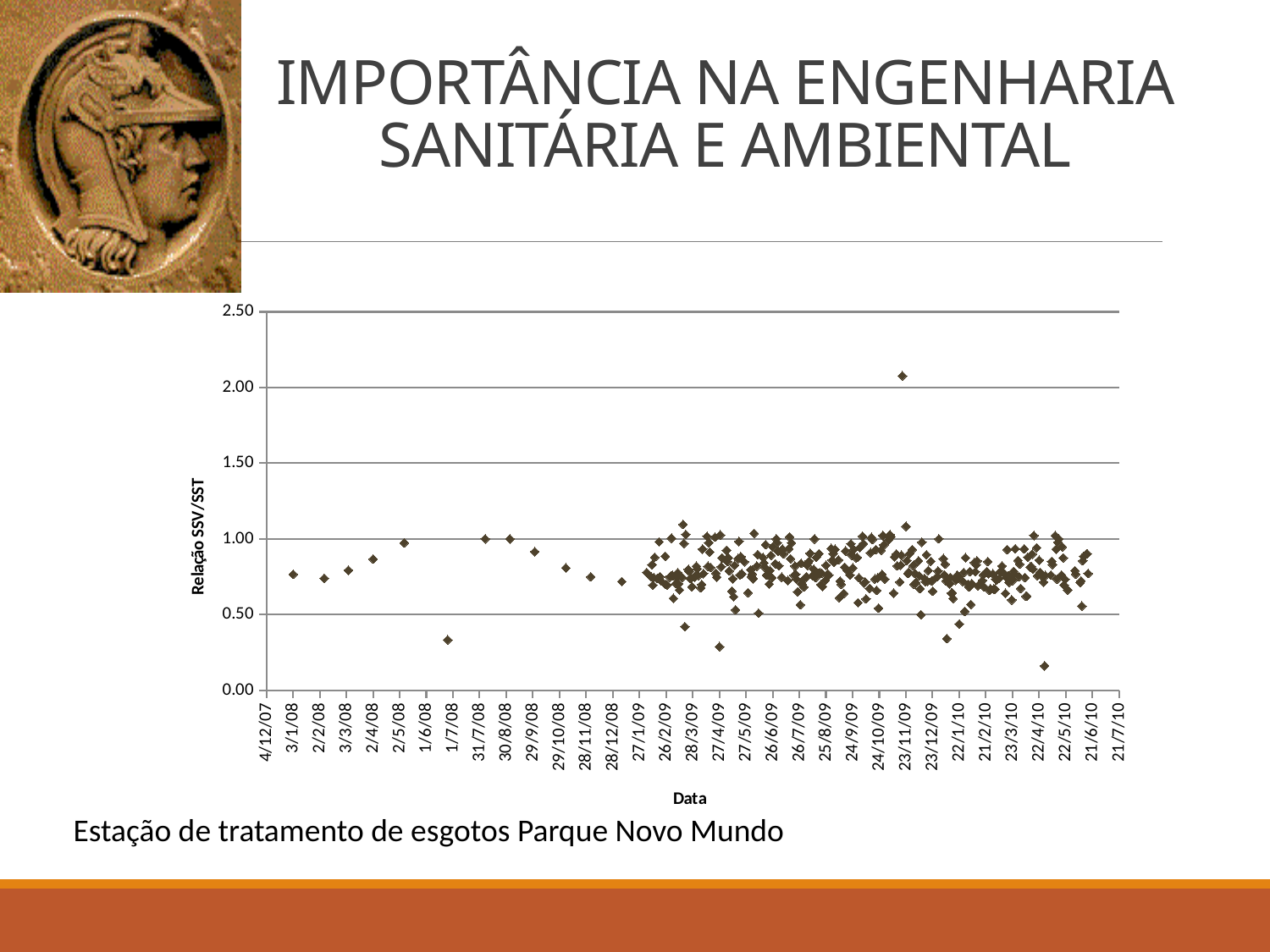
Is the highest plotted value on the chart, near 23/11/09, greater or less than 2.00? greater Is the isolated point plotted near 1/7/08 greater or less than 0.50? less Is the first plotted point, near 3/1/08, greater or less than 1.00? less What is the title of the horizontal axis of the chart? Data What is the title of the vertical axis of the chart? Relação SSV/SST What kind of chart is shown on the slide? scatter chart Which is larger: the value plotted near 23/11/09 at the top of the chart or the value plotted near 1/7/08? the value near 23/11/09 What is the maximum value shown on the vertical axis of the chart? 2.50